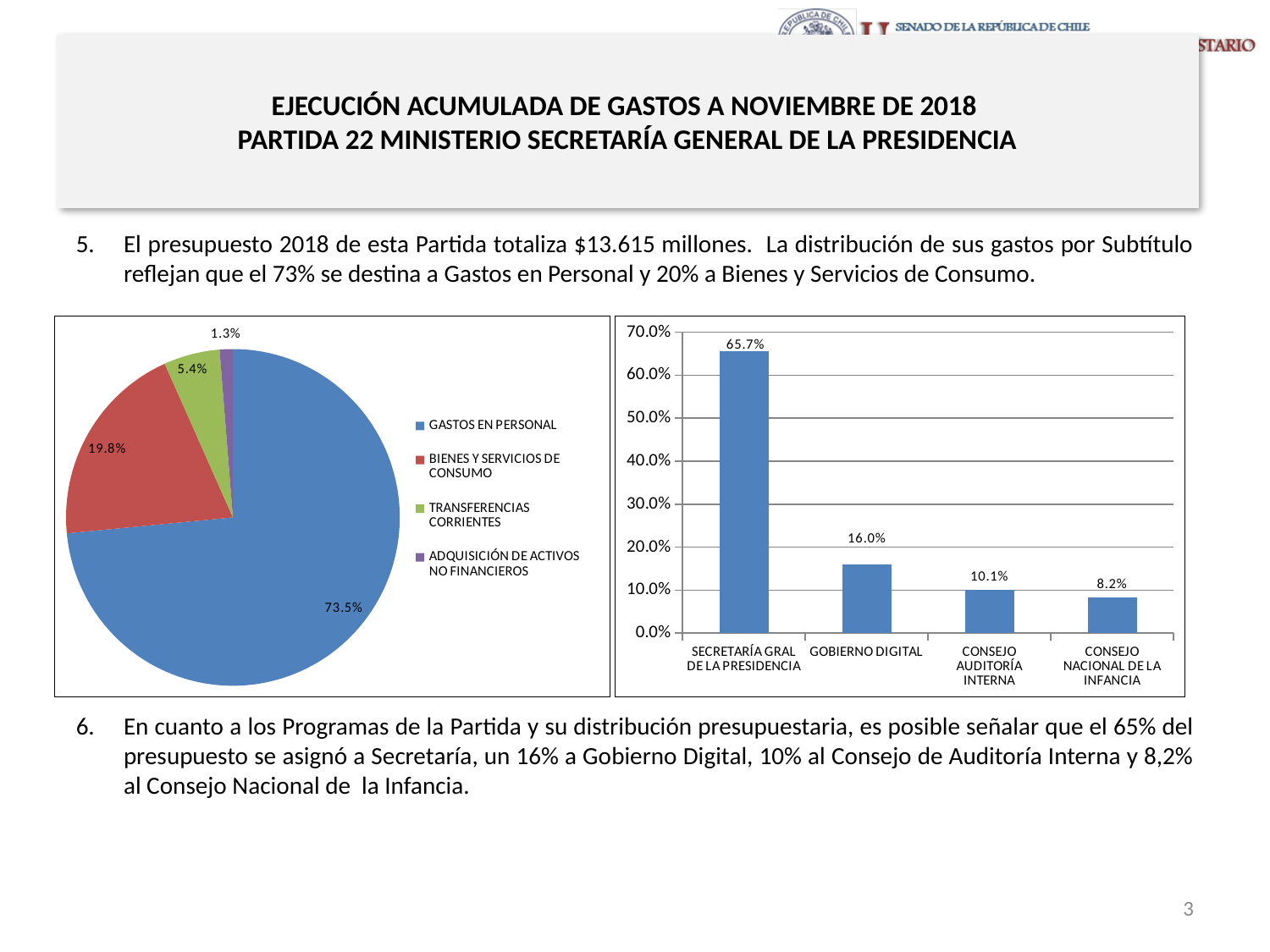
In the pie chart on the left, what share does GASTOS EN PERSONAL have? 73.5% In the pie chart on the left, which category has the smallest slice? ADQUISICIÓN DE ACTIVOS NO FINANCIEROS In the pie chart on the left, how many categories does the legend list? 4 In the bar chart on the right, which category has the highest value? SECRETARÍA GRAL DE LA PRESIDENCIA In the bar chart on the right, is the value for CONSEJO AUDITORÍA INTERNA greater or less than 10.0%? greater In the pie chart on the left, what is the difference between the shares of TRANSFERENCIAS CORRIENTES and ADQUISICIÓN DE ACTIVOS NO FINANCIEROS? 4.1% In the bar chart on the right, what is the value for CONSEJO NACIONAL DE LA INFANCIA? 8.2% What kind of chart is the chart on the right? bar chart In the bar chart on the right, what is the difference between SECRETARÍA GRAL DE LA PRESIDENCIA and GOBIERNO DIGITAL? 49.7% In the bar chart on the right, what is the value for GOBIERNO DIGITAL? 16.0% In the bar chart on the right, do the values rise or fall from left to right along the x axis? fall In the pie chart on the left, what share does BIENES Y SERVICIOS DE CONSUMO have? 19.8%